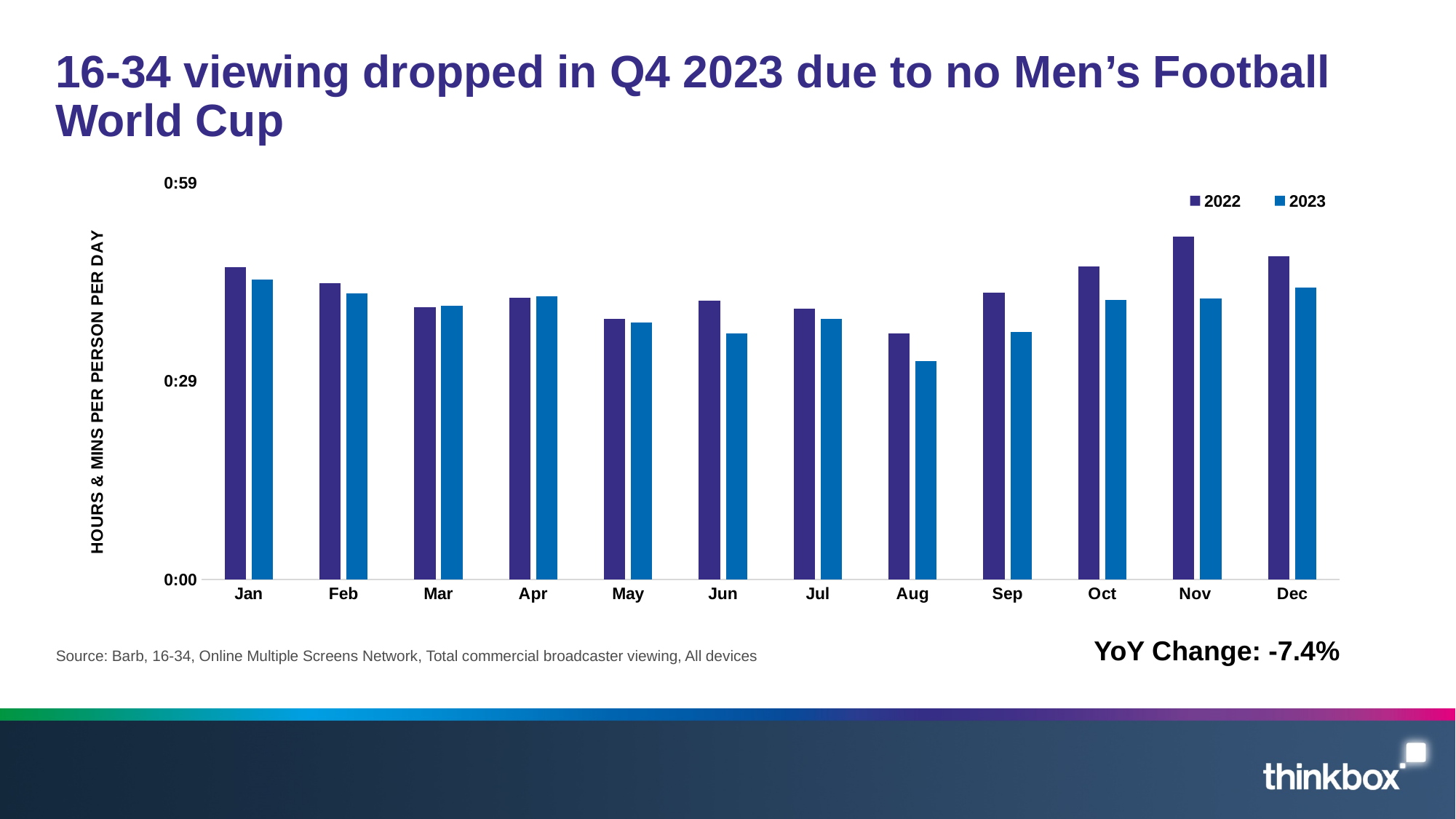
Is the value for Nov 2022 greater or less than 0:59? less How many months are shown along the x axis? 12 Is the value for Aug 2023 greater or less than 0:29? greater Which series is shown in dark purple according to the legend? 2022 Which month has the lowest 2022 bar? Aug How many series does the legend list? 2 In Nov, which series has the larger value, 2022 or 2023? 2022 Which month has the highest 2022 bar? Nov Which month has the lowest 2023 bar? Aug What is the y-axis label of the chart? HOURS & MINS PER PERSON PER DAY What kind of chart is shown on the slide? Bar chart In Aug, which series has the larger value, 2022 or 2023? 2022